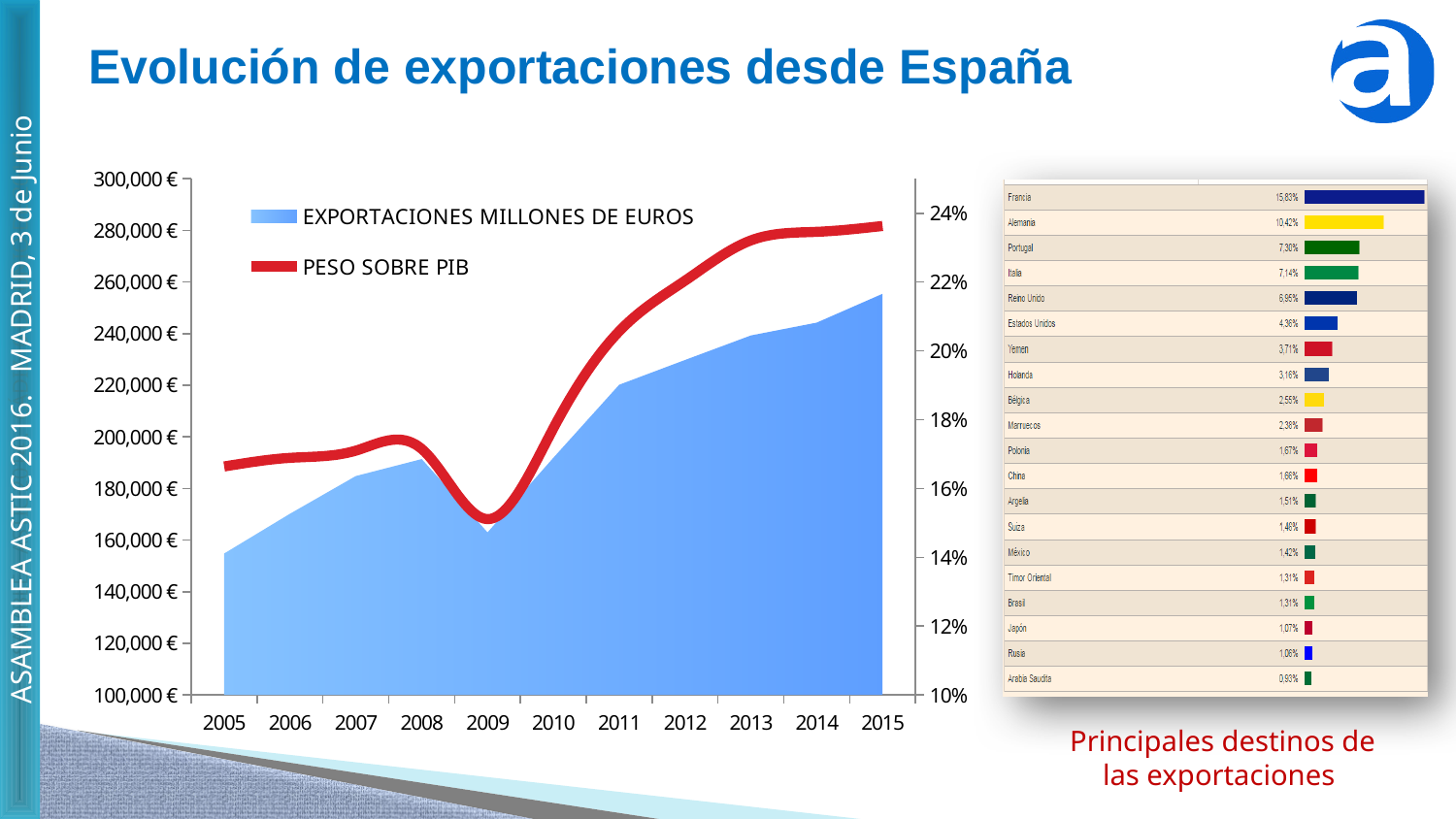
In the chart titled 'Principales destinos de las exportaciones', which country has the lowest share? Arabia Saudita In the chart titled 'Principales destinos de las exportaciones', which country has the highest share? Francia In the left chart, in which year is PESO SOBRE PIB lowest? 2009 In the chart titled 'Principales destinos de las exportaciones', what kind of chart is it? bar chart In the left chart, is the value of EXPORTACIONES MILLONES DE EUROS for 2015 greater or less than 240,000 €? greater In the left chart, how many years are shown on the x axis? 11 In the left chart, is the value of PESO SOBRE PIB for 2009 greater or less than 16%? less In the left chart, does EXPORTACIONES MILLONES DE EUROS rise or fall from 2009 to 2015? rise In the chart titled 'Principales destinos de las exportaciones', what is the value for Alemania? 10,42% In the left chart, in which year is PESO SOBRE PIB highest? 2015 In the left chart, in which year is EXPORTACIONES MILLONES DE EUROS lowest? 2005 In the left chart, how many series does the legend list? 2